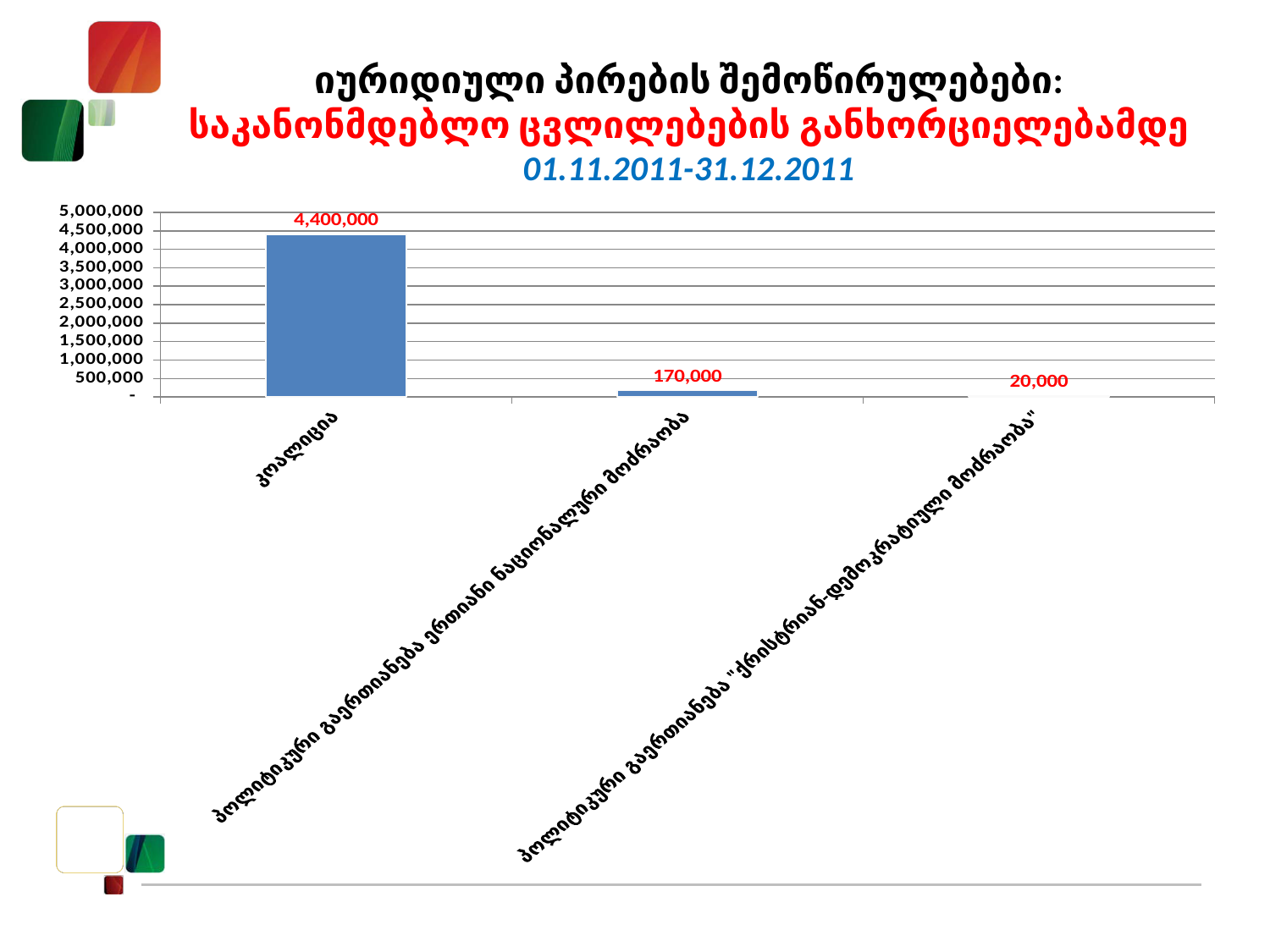
What is the difference between the values for პოლიტიკური გაერთიანება ერთიანი ნაციონალური მოძრაობა and პოლიტიკური გაერთიანება "ქრისტიან-დემოკრატიული მოძრაობა"? 150,000 What is the value for კოალიცია? 4,400,000 What is the difference between the values for კოალიცია and პოლიტიკური გაერთიანება ერთიანი ნაციონალური მოძრაობა? 4,230,000 Which is larger: the value for პოლიტიკური გაერთიანება ერთიანი ნაციონალური მოძრაობა or the value for პოლიტიკური გაერთიანება "ქრისტიან-დემოკრატიული მოძრაობა"? პოლიტიკური გაერთიანება ერთიანი ნაციონალური მოძრაობა Which category has the lowest value? პოლიტიკური გაერთიანება "ქრისტიან-დემოკრატიული მოძრაობა" Which category has the highest value? კოალიცია What is the value for პოლიტიკური გაერთიანება ერთიანი ნაციონალური მოძრაობა? 170,000 What date range is shown in the slide title? 01.11.2011-31.12.2011 How many categories are shown on the chart? 3 Is the value for კოალიცია greater or less than 4,000,000? greater What is the value for პოლიტიკური გაერთიანება "ქრისტიან-დემოკრატიული მოძრაობა"? 20,000 What kind of chart is shown on the slide? bar chart